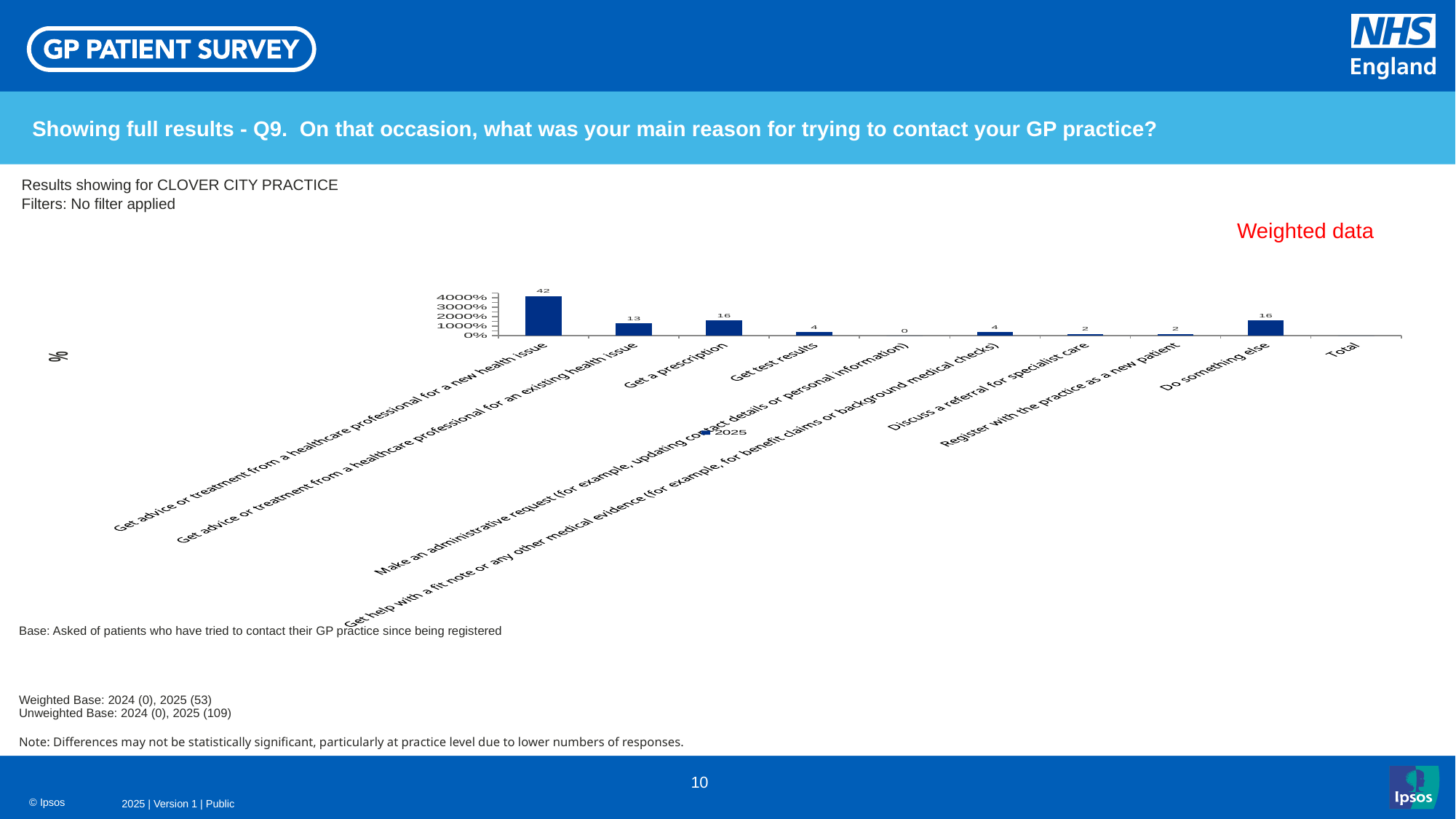
What kind of chart is shown on the slide? Bar chart What is the difference between the value for a new health issue and the value for an existing health issue? 29 Which is larger: the value for 'Get a prescription' or the value for 'Get advice or treatment from a healthcare professional for an existing health issue'? Get a prescription What is the value for 'Do something else'? 16 Which category has the lowest value? Make an administrative request (for example, updating contact details or personal information) What is the value for 'Get advice or treatment from a healthcare professional for a new health issue'? 42 What is the value for 'Get a prescription'? 16 What is the value for 'Get test results'? 4 Which category has the highest value? Get advice or treatment from a healthcare professional for a new health issue How many series does the legend list? 1 What year does the legend entry show? 2025 What is the value for 'Get advice or treatment from a healthcare professional for an existing health issue'? 13